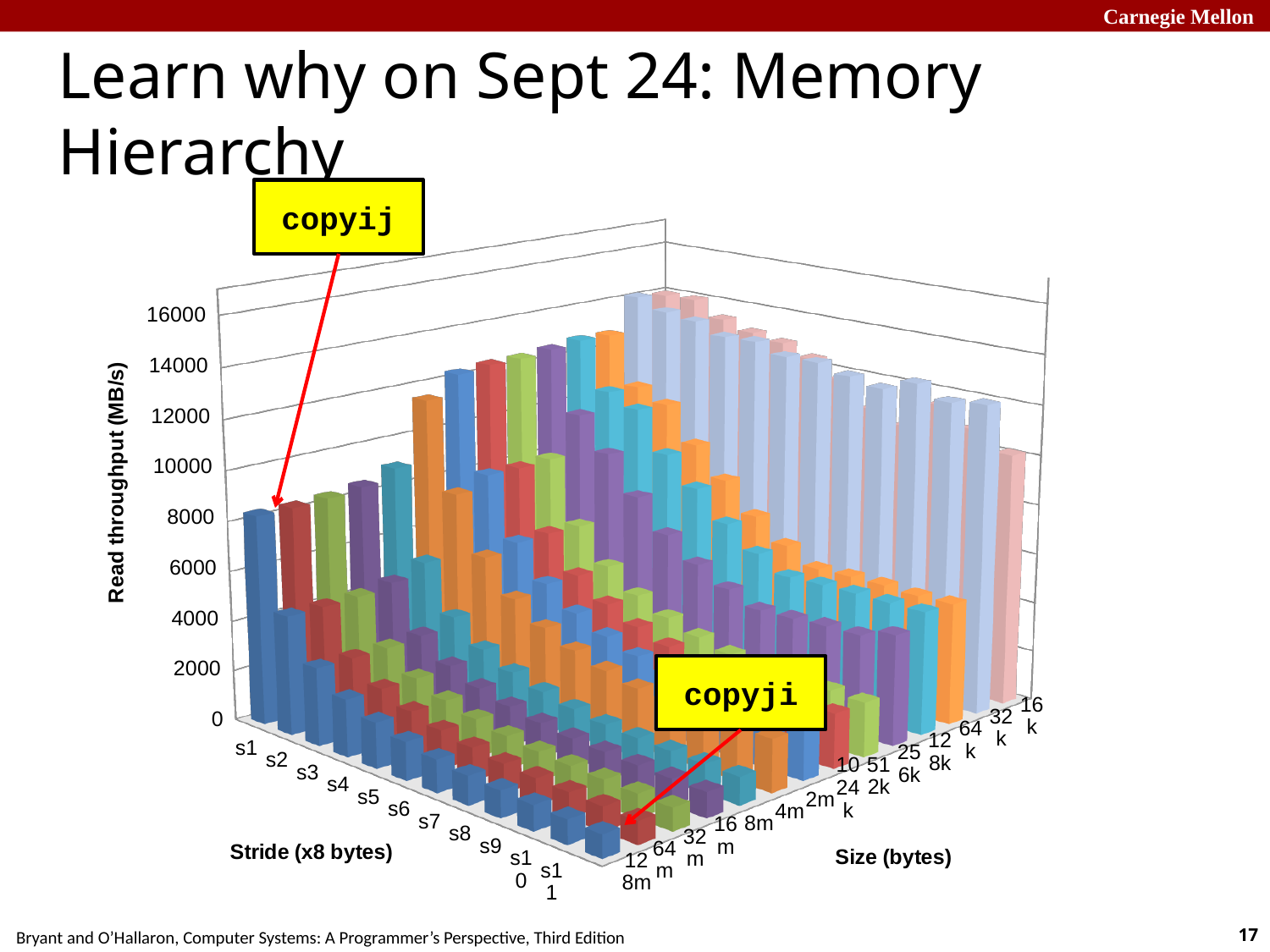
For stride s1, which size has the higher read throughput, 128m or 64k? 64k Is the read throughput for stride s11 at size 128m (the bar labelled copyji) greater or less than 2000? less How many stride categories are shown along the Stride (x8 bytes) axis? 11 At size 128m, which stride has the higher read throughput, s1 or s11? s1 What is the highest tick value shown on the Read throughput (MB/s) axis? 16000 How many size categories are shown along the Size (bytes) axis? 14 What kind of chart is shown on the slide? 3D bar chart Is the read throughput for stride s1 at size 128m greater or less than 10000? less What is the label of the vertical axis of the chart? Read throughput (MB/s) Is the read throughput for stride s1 at size 128m greater or less than 6000? greater What are the labels of the two horizontal axes of the chart? Stride (x8 bytes) and Size (bytes) At size 128m, does read throughput rise or fall as the stride increases from s1 to s11? fall